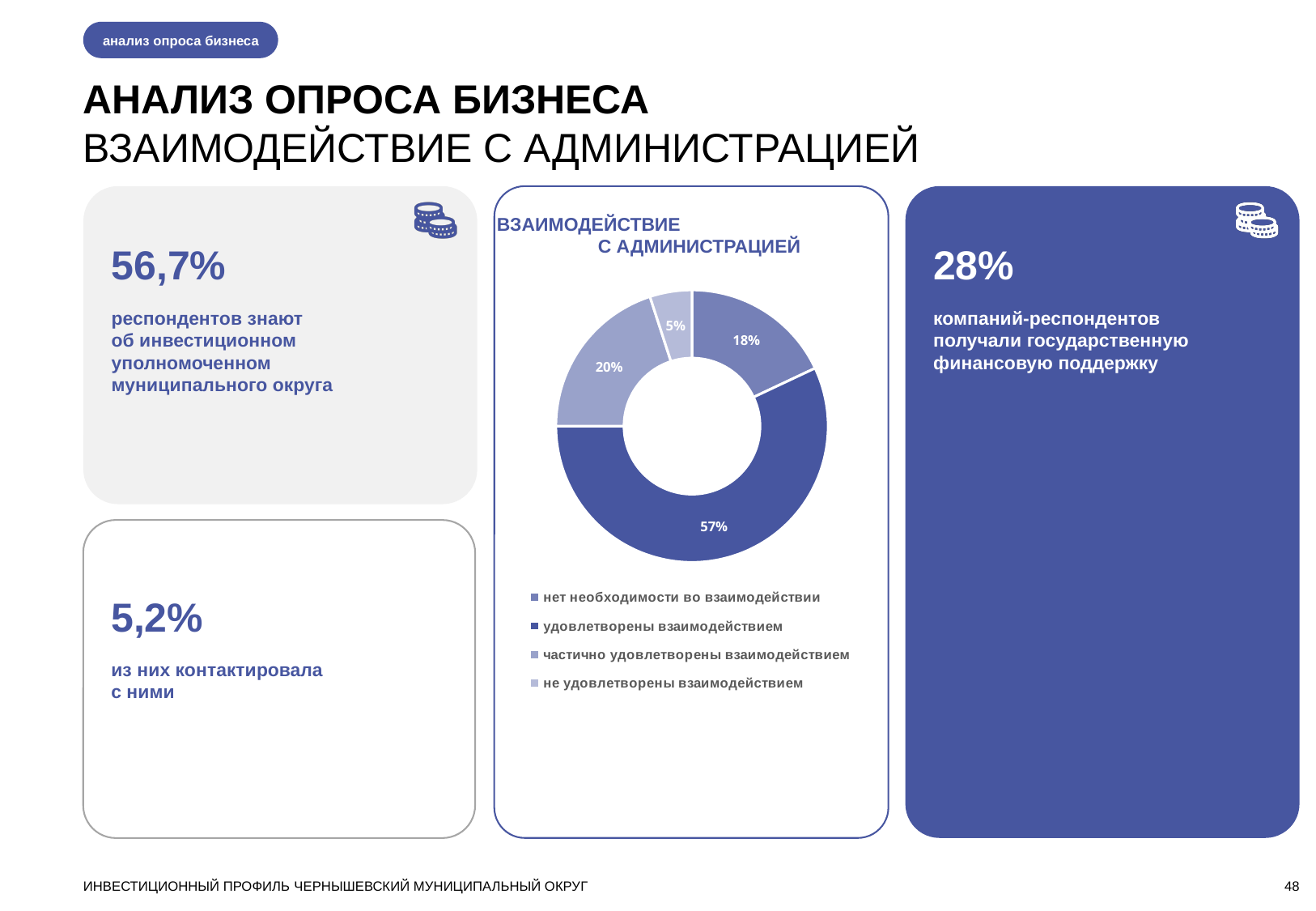
Which category has the smallest share in the chart? не удовлетворены взаимодействием What share of respondents are 'частично удовлетворены взаимодействием'? 20% What is the title of the chart? ВЗАИМОДЕЙСТВИЕ С АДМИНИСТРАЦИЕЙ How many categories does the chart legend list? 4 What share of respondents answered 'нет необходимости во взаимодействии'? 18% Which is larger: the share of 'частично удовлетворены взаимодействием' or 'нет необходимости во взаимодействии'? частично удовлетворены взаимодействием What share of respondents are 'удовлетворены взаимодействием'? 57% Which category has the largest share in the chart? удовлетворены взаимодействием What is the difference between the shares of 'удовлетворены взаимодействием' and 'частично удовлетворены взаимодействием'? 37% What type of chart is shown on the slide? Pie (donut) chart What is the combined share of 'частично удовлетворены взаимодействием' and 'не удовлетворены взаимодействием'? 25% What share of respondents are 'не удовлетворены взаимодействием'? 5%